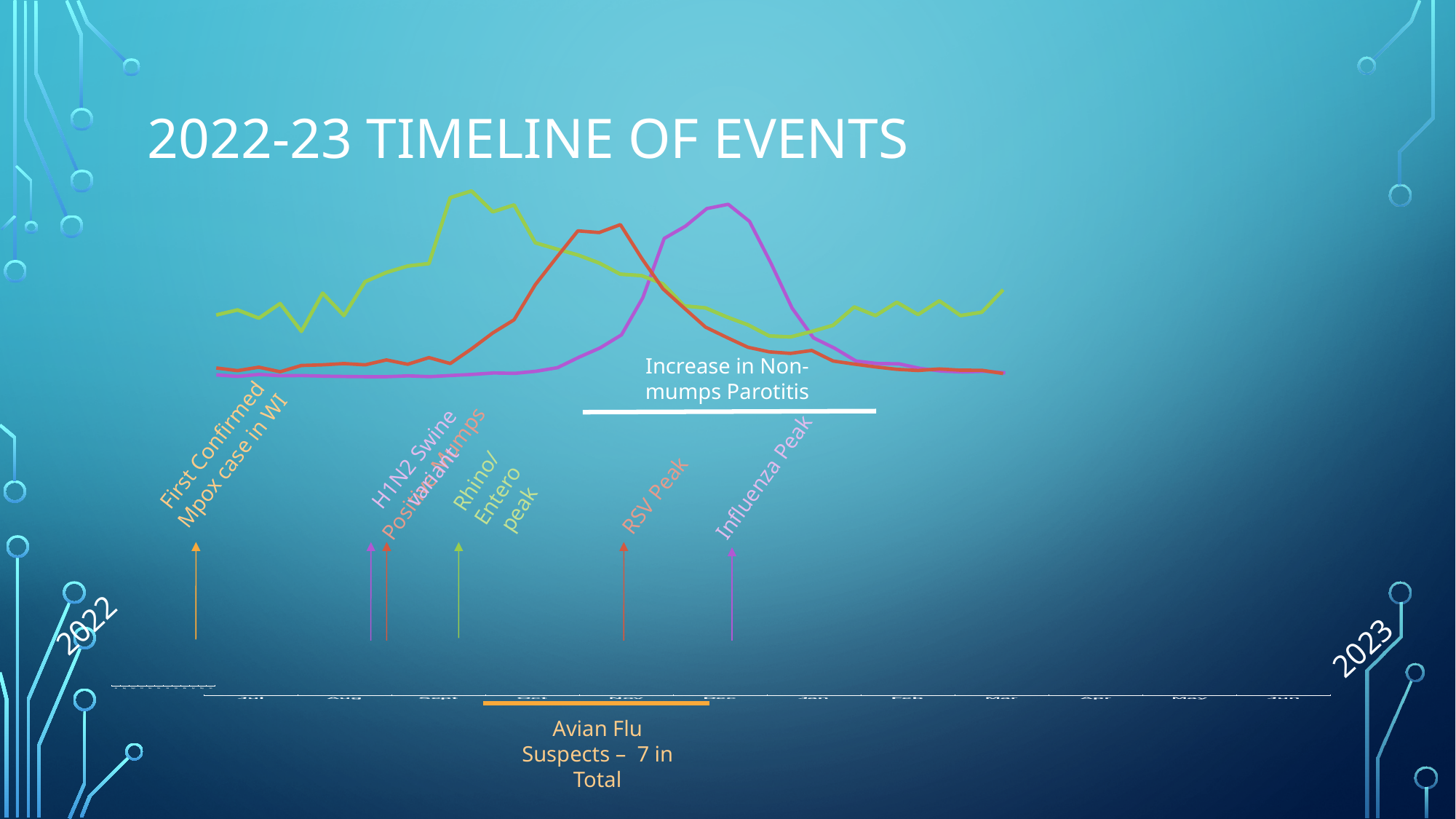
At Dec, which line is higher: the purple line or the green line? purple How many month labels are shown along the x axis of the chart? 12 According to the annotation below the x axis, how many Avian Flu suspects were there in total? 7 How many lines are plotted on the chart? 3 Which coloured line reaches its peak earliest along the x axis? green At Sept, which line is higher: the green line or the orange line? green What is the title of the slide containing the chart? 2022-23 Timeline of Events Does the purple line rise or fall between Oct and Dec? rise Which coloured line reaches its peak latest along the x axis? purple Does the green line rise or fall between Sept and Dec? fall What kind of chart is shown on the slide? line chart Does the orange line rise or fall between Nov and Jan? fall